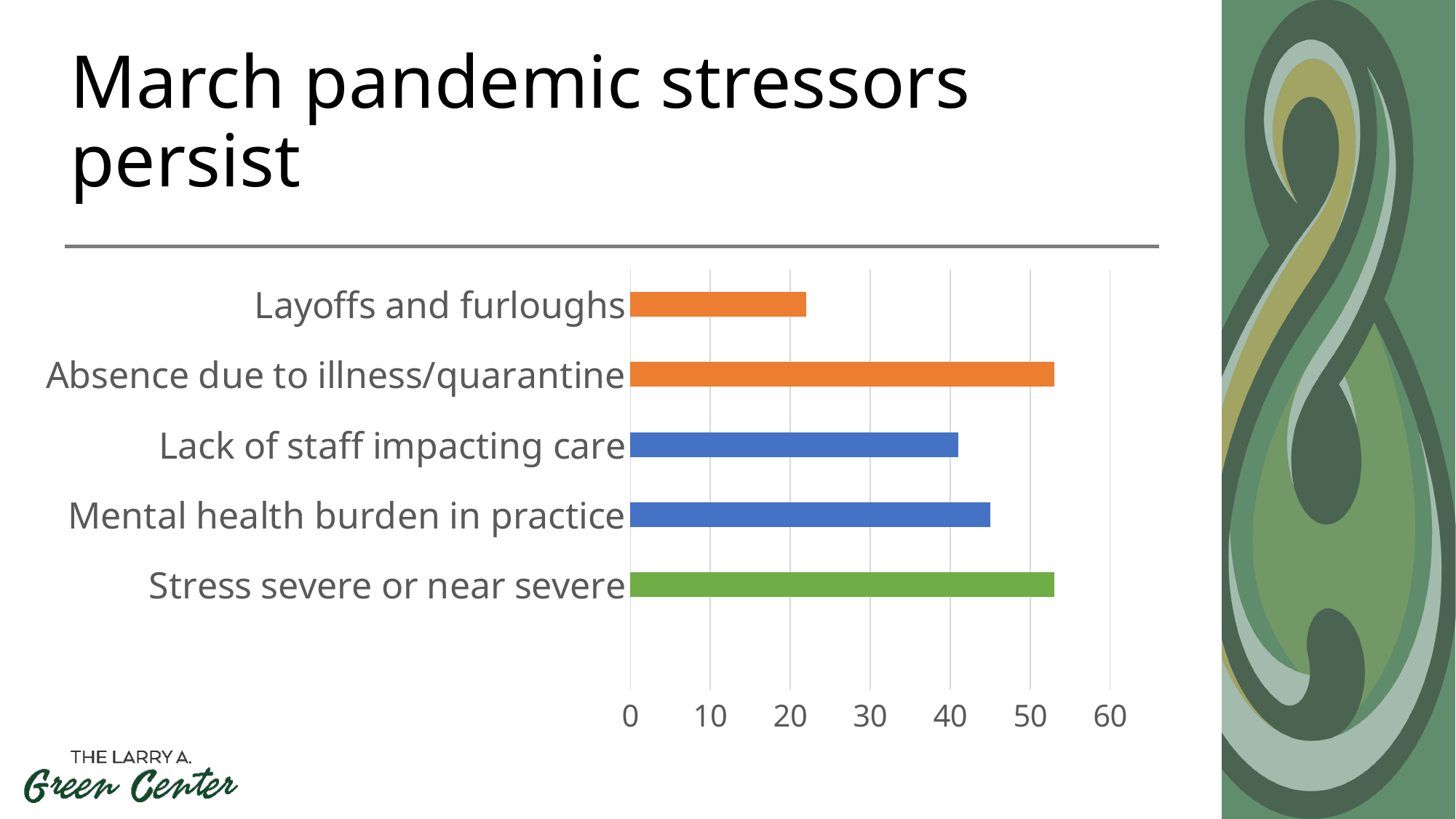
Which category has the lowest value in the chart? Layoffs and furloughs Is the value for Layoffs and furloughs greater or less than 30? less Is the value for Layoffs and furloughs greater or less than 20? greater Which is larger, the value for Layoffs and furloughs or the value for Lack of staff impacting care? Lack of staff impacting care Is the value for Lack of staff impacting care greater or less than 30? greater How many categories are plotted in the chart? 5 What is the title of the slide containing the chart? March pandemic stressors persist What colour is the bar for Stress severe or near severe? green What kind of chart is shown on the slide? bar chart